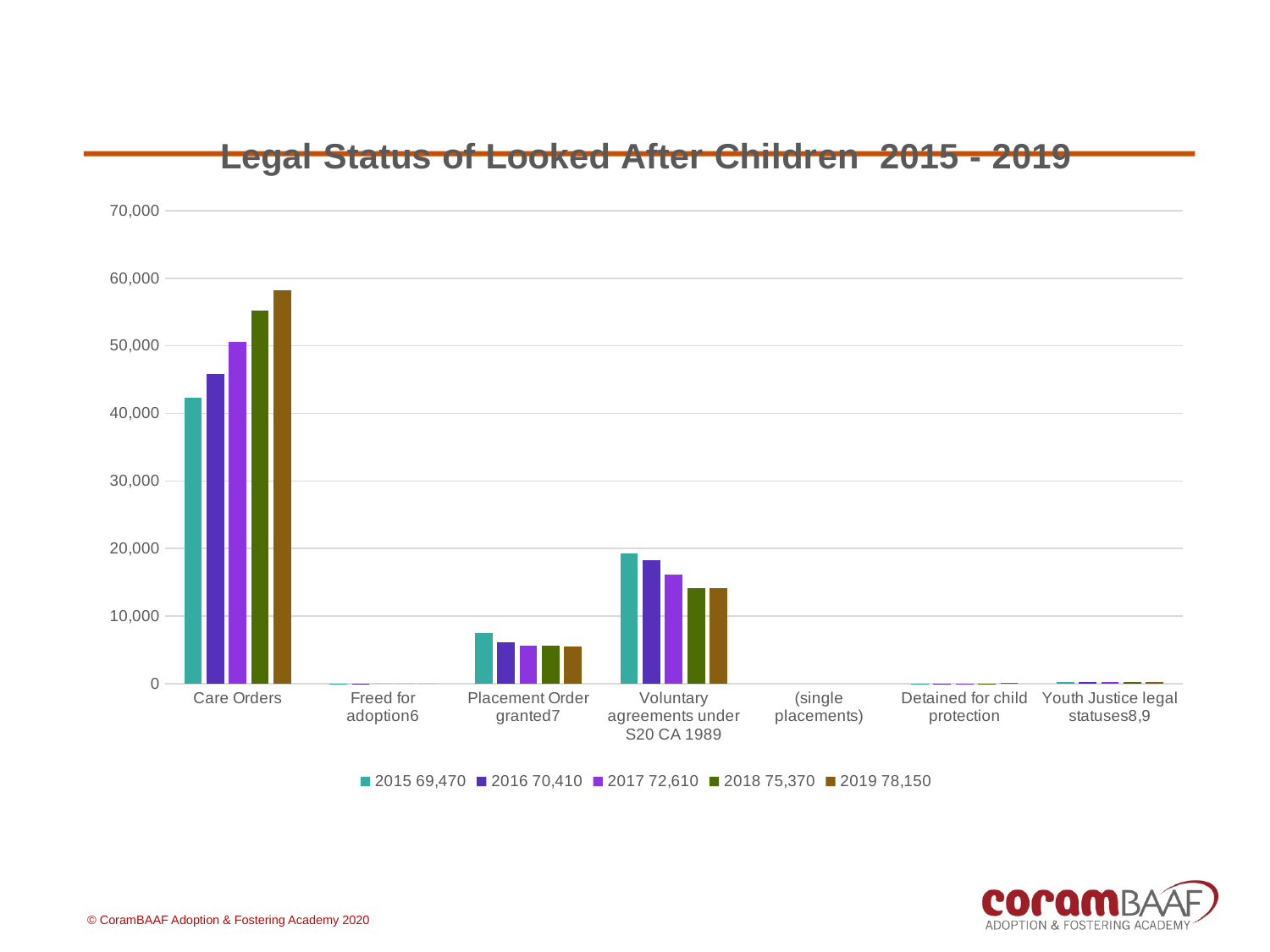
What total figure does the legend give for 2019? 78,150 How many series does the legend list? 5 What kind of chart is shown on the slide? bar chart Is the 2019 value for Care Orders greater or less than 50,000? greater How many categories are shown along the x axis? 7 Which category has the highest values across all years? Care Orders Do the values for Voluntary agreements under S20 CA 1989 rise or fall from 2015 to 2019? fall Do the Care Orders values rise or fall from 2015 to 2019? rise Is the 2015 value for Placement Order granted greater or less than 10,000? less What is the title of the chart? Legal Status of Looked After Children 2015 - 2019 Is the 2015 value for Voluntary agreements under S20 CA 1989 greater or less than 20,000? less Which is larger in 2019: Care Orders or Voluntary agreements under S20 CA 1989? Care Orders